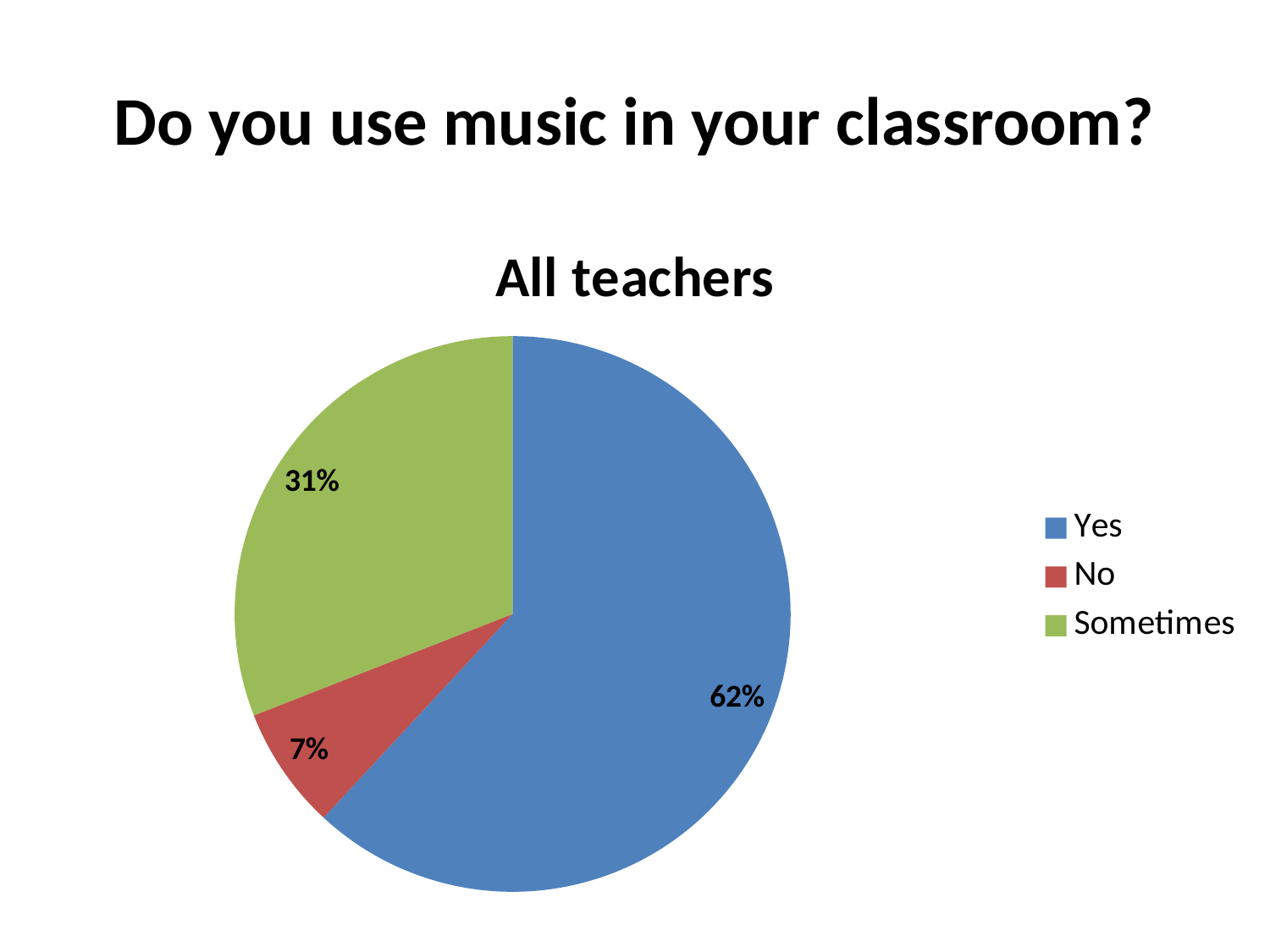
What is the difference in percentage points between "Yes" and "Sometimes"? 31 What percentage of teachers answered "Sometimes"? 31% How many categories does the legend list? 3 Which is larger, the share for "Sometimes" or the share for "No"? Sometimes What type of chart is shown on the slide? pie chart Which response has the largest share of the pie? Yes What is the chart's title? All teachers What percentage of teachers answered "No"? 7% What percentage of teachers answered "Yes"? 62% What colour is the "Sometimes" slice? green Which response has the smallest share of the pie? No What is the combined share of "No" and "Sometimes"? 38%